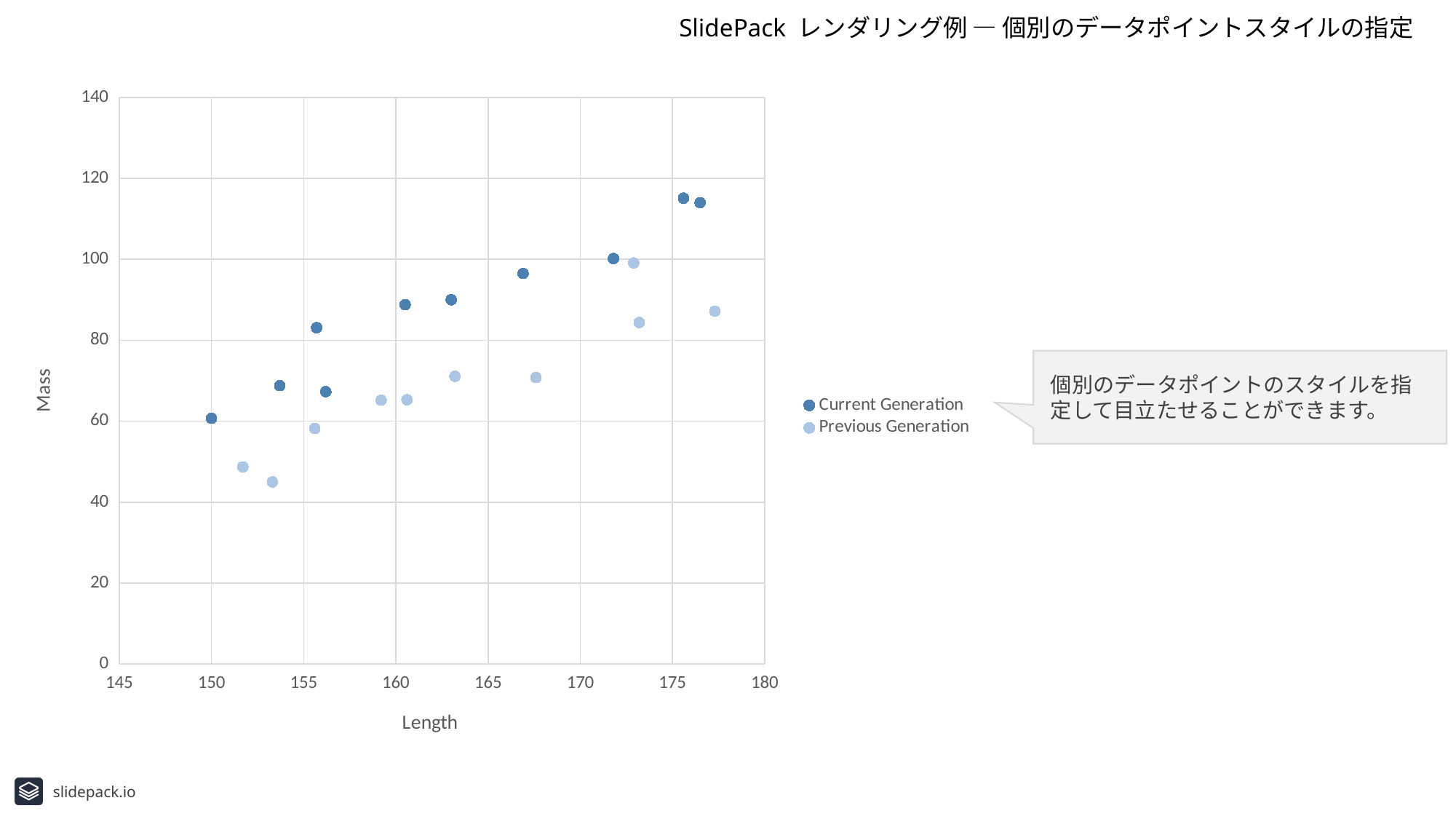
What is the title of the vertical axis? Mass Is the Mass of the lowest Previous Generation point greater or less than 60? less What kind of chart is shown on the slide? scatter chart Is any Previous Generation point above a Mass of 120? no Which series contains the point with the lowest Mass? Previous Generation Do the Current Generation values generally rise or fall as Length increases? rise What are the names of the two series in the legend? Current Generation, Previous Generation Is the Mass of the Current Generation point at Length 150 greater or less than 80? less Which series contains the point with the highest Mass? Current Generation How many Current Generation points are plotted? 10 How many series does the legend list? 2